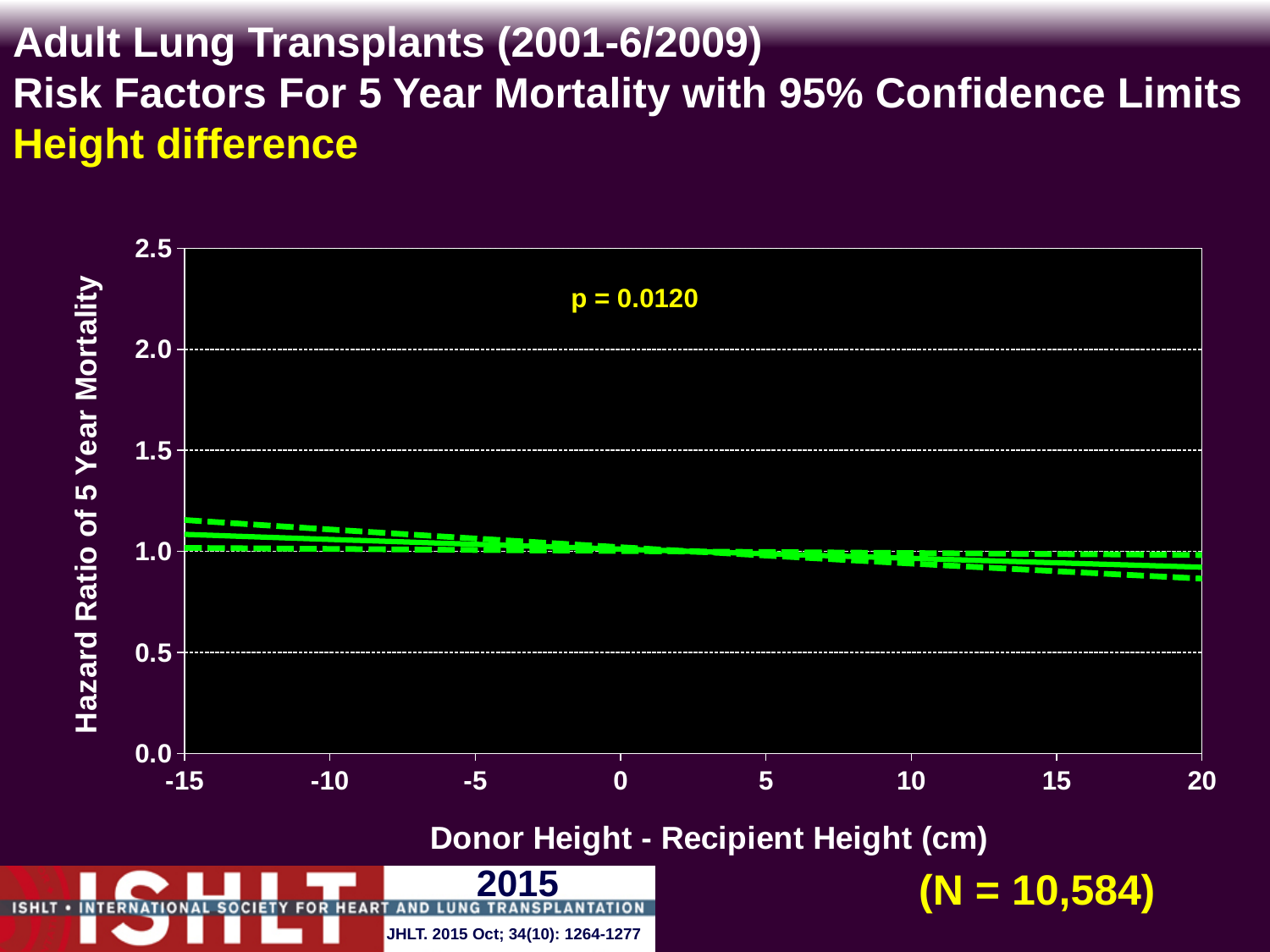
How many tick labels are shown on the x axis of the chart? 8 Is the hazard ratio of 5 year mortality at a height difference of 0 cm greater or less than 1.5? less Does the hazard ratio of 5 year mortality rise or fall as the donor height minus recipient height increases from -15 to 20 cm? fall What kind of chart is shown on the slide? line chart Is the hazard ratio of 5 year mortality at a height difference of 20 cm greater or less than 1.0? less What is the highest value labelled on the y axis of the chart? 2.5 What p-value is printed on the chart? p = 0.0120 Is the hazard ratio of 5 year mortality at a height difference of -15 cm greater or less than 1.0? greater